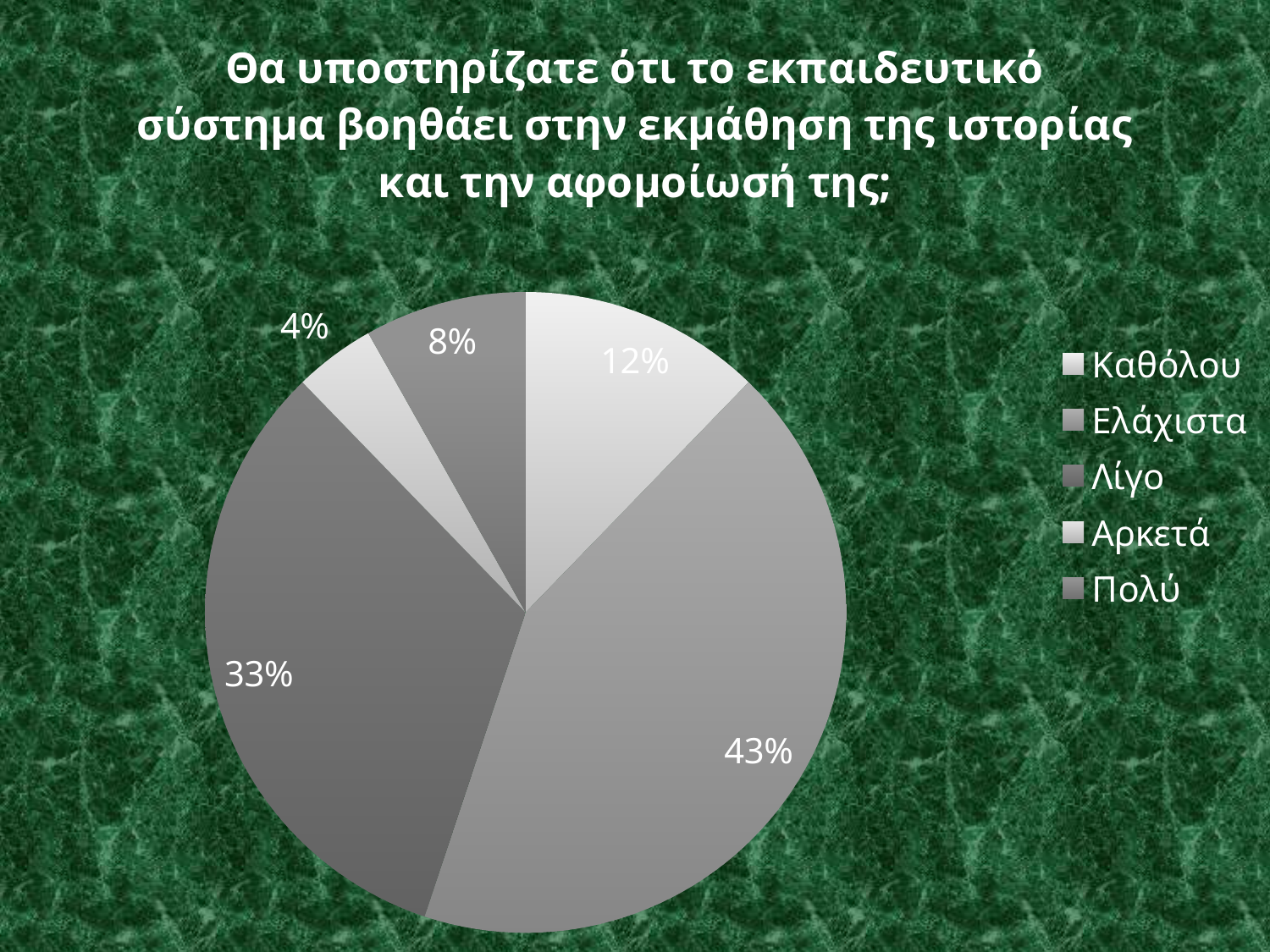
What percentage of the pie is labelled Αρκετά? 4% What percentage of the pie is labelled Λίγο? 33% Which slice is larger, Καθόλου or Πολύ? Καθόλου Which category has the smallest slice of the pie? Αρκετά What type of chart is shown on the slide? Pie chart How many categories does the pie chart show? 5 What percentage of the pie is labelled Πολύ? 8% What is the combined share of the Αρκετά and Πολύ slices? 12% What percentage of the pie is labelled Ελάχιστα? 43% What is the difference in percentage points between the Ελάχιστα slice and the Λίγο slice? 10 Which category has the largest slice of the pie? Ελάχιστα What percentage of the pie is labelled Καθόλου? 12%